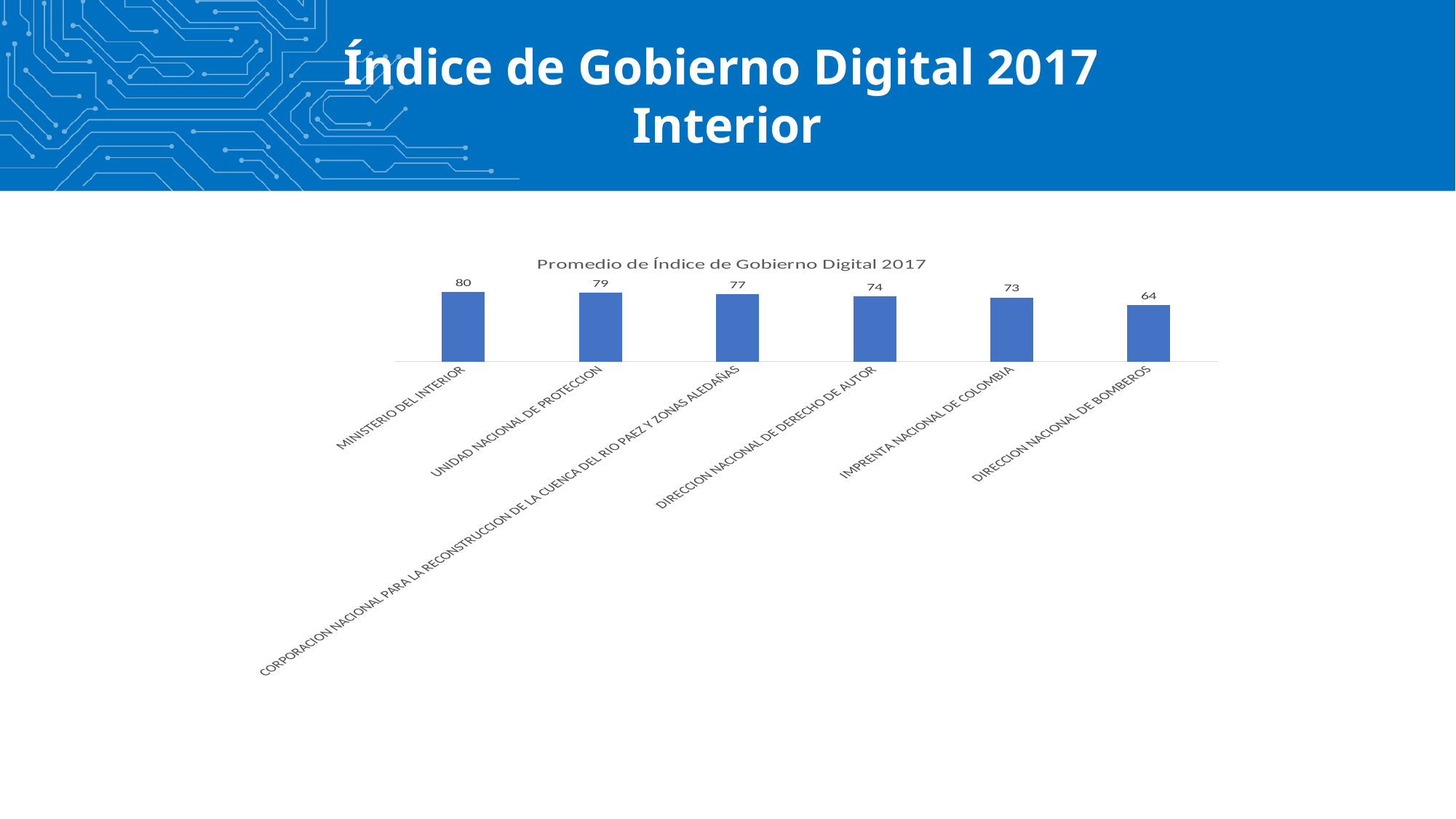
What is the title of the chart? Promedio de Índice de Gobierno Digital 2017 Do the values rise or fall from left to right along the x axis? Fall What is the difference between the values for MINISTERIO DEL INTERIOR and DIRECCION NACIONAL DE BOMBEROS? 16 What kind of chart is shown? Bar chart What is the value for MINISTERIO DEL INTERIOR? 80 Which entity has the highest value? MINISTERIO DEL INTERIOR Which entity has the lowest value? DIRECCION NACIONAL DE BOMBEROS What is the value for DIRECCION NACIONAL DE DERECHO DE AUTOR? 74 How many entities are shown in the chart? 6 Which is larger, the value for IMPRENTA NACIONAL DE COLOMBIA or the value for DIRECCION NACIONAL DE BOMBEROS? IMPRENTA NACIONAL DE COLOMBIA What is the value for UNIDAD NACIONAL DE PROTECCION? 79 What is the value for DIRECCION NACIONAL DE BOMBEROS? 64